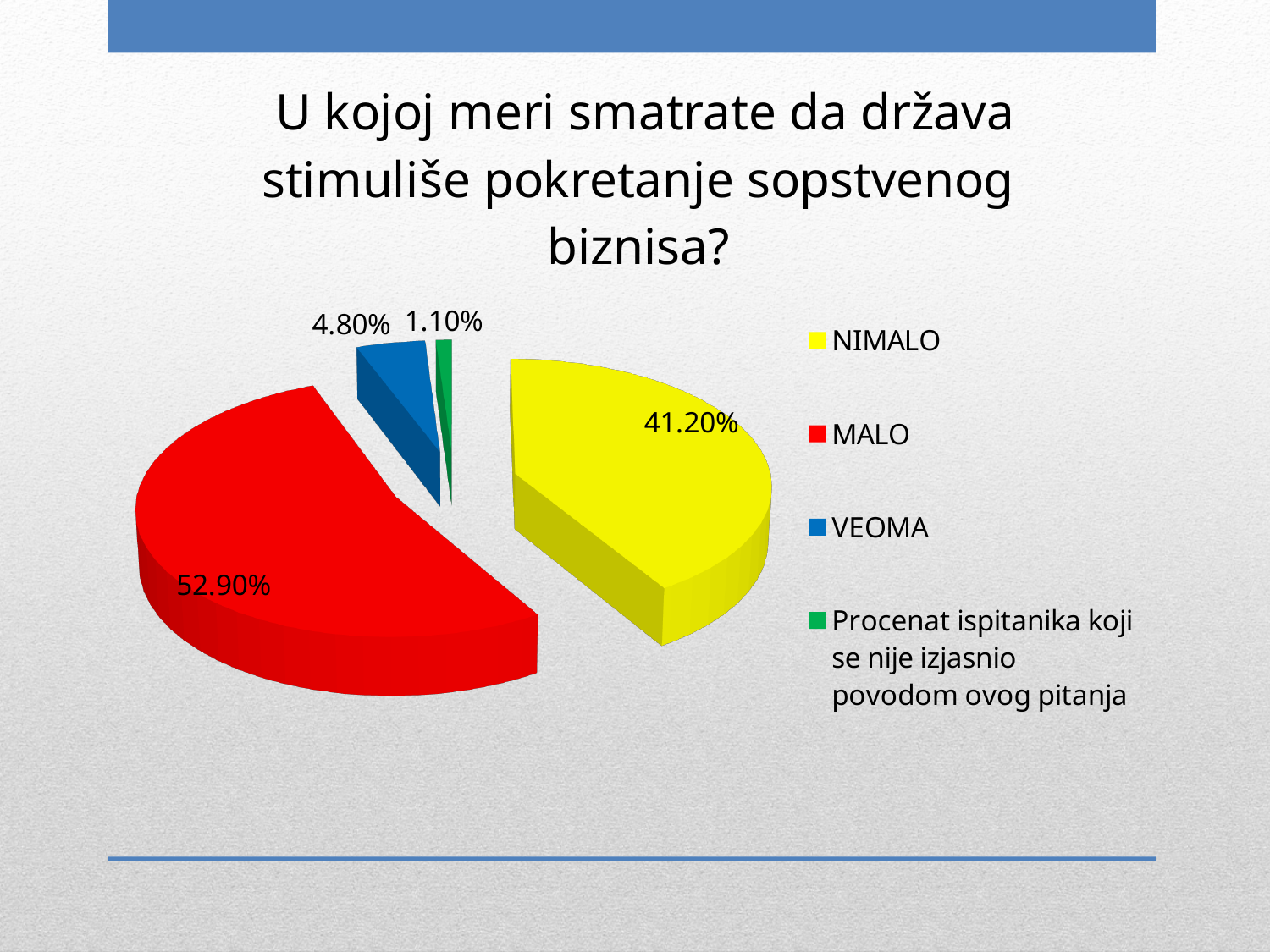
What is the value for the slice labelled 'Procenat ispitanika koji se nije izjasnio povodom ovog pitanja'? 1.10% Which category has the smallest share of the pie? Procenat ispitanika koji se nije izjasnio povodom ovog pitanja How many slices does the pie chart have? 4 What is the value for MALO? 52.90% What is the value for NIMALO? 41.20% Which category has the largest share of the pie? MALO What is the difference between the values for MALO and NIMALO? 11.70% Which is larger, the value for VEOMA or the value for NIMALO? NIMALO What kind of chart is shown on the slide? pie chart How many entries does the legend list? 4 What colour is the slice for VEOMA? blue What is the value for VEOMA? 4.80%